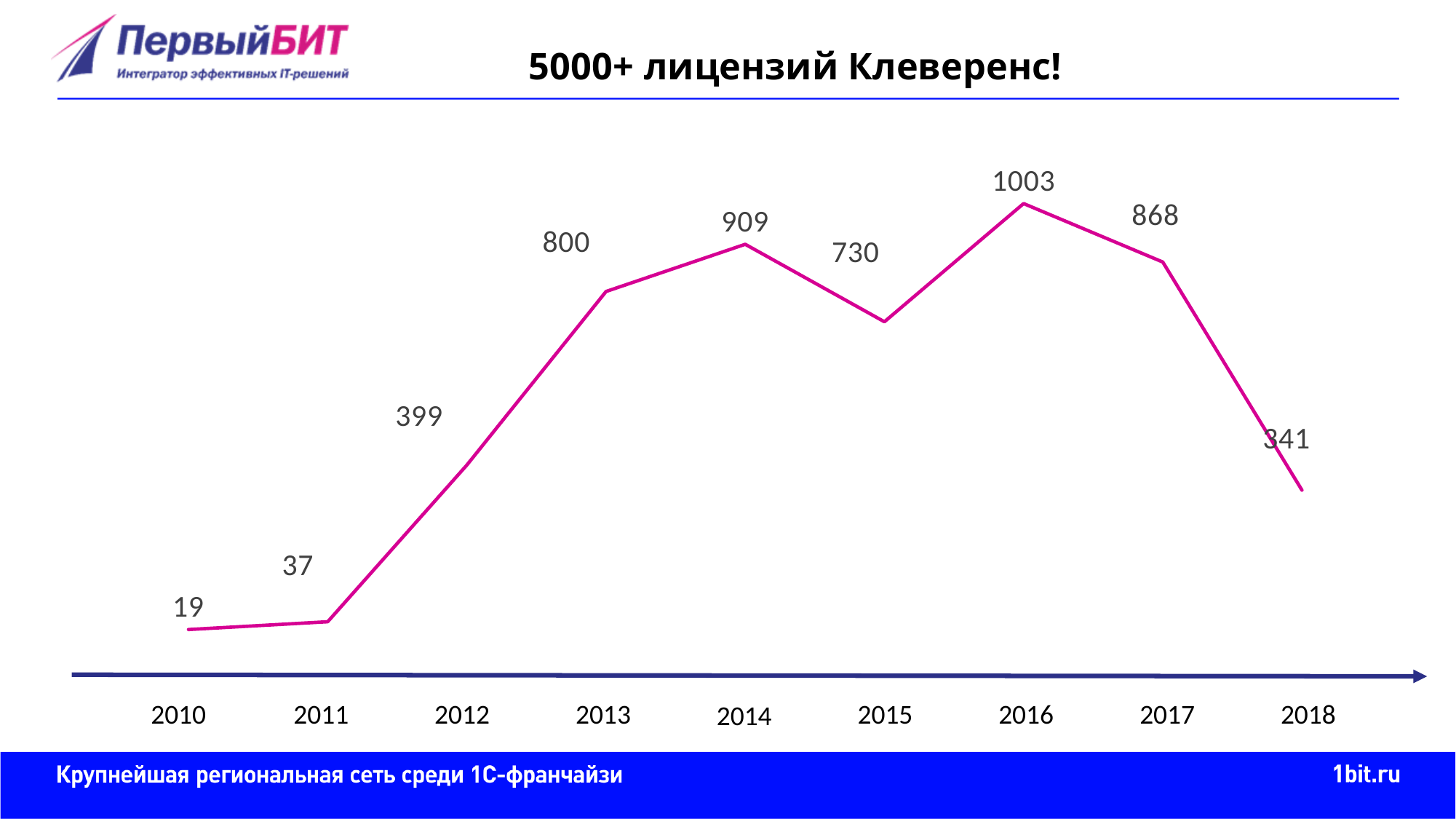
Which is larger, the value for 2014 or the value for 2015? 2014 Which year has the lowest value? 2010 What is the value for 2018? 341 What kind of chart is shown on the slide? line chart How many years are plotted on the chart? 9 Which year has the highest value? 2016 What is the value for 2010? 19 Do the values rise or fall from 2010 to 2013? rise What is the value for 2016? 1003 What is the difference between the values for 2016 and 2017? 135 What is the difference between the values for 2012 and 2011? 362 What is the value for 2013? 800